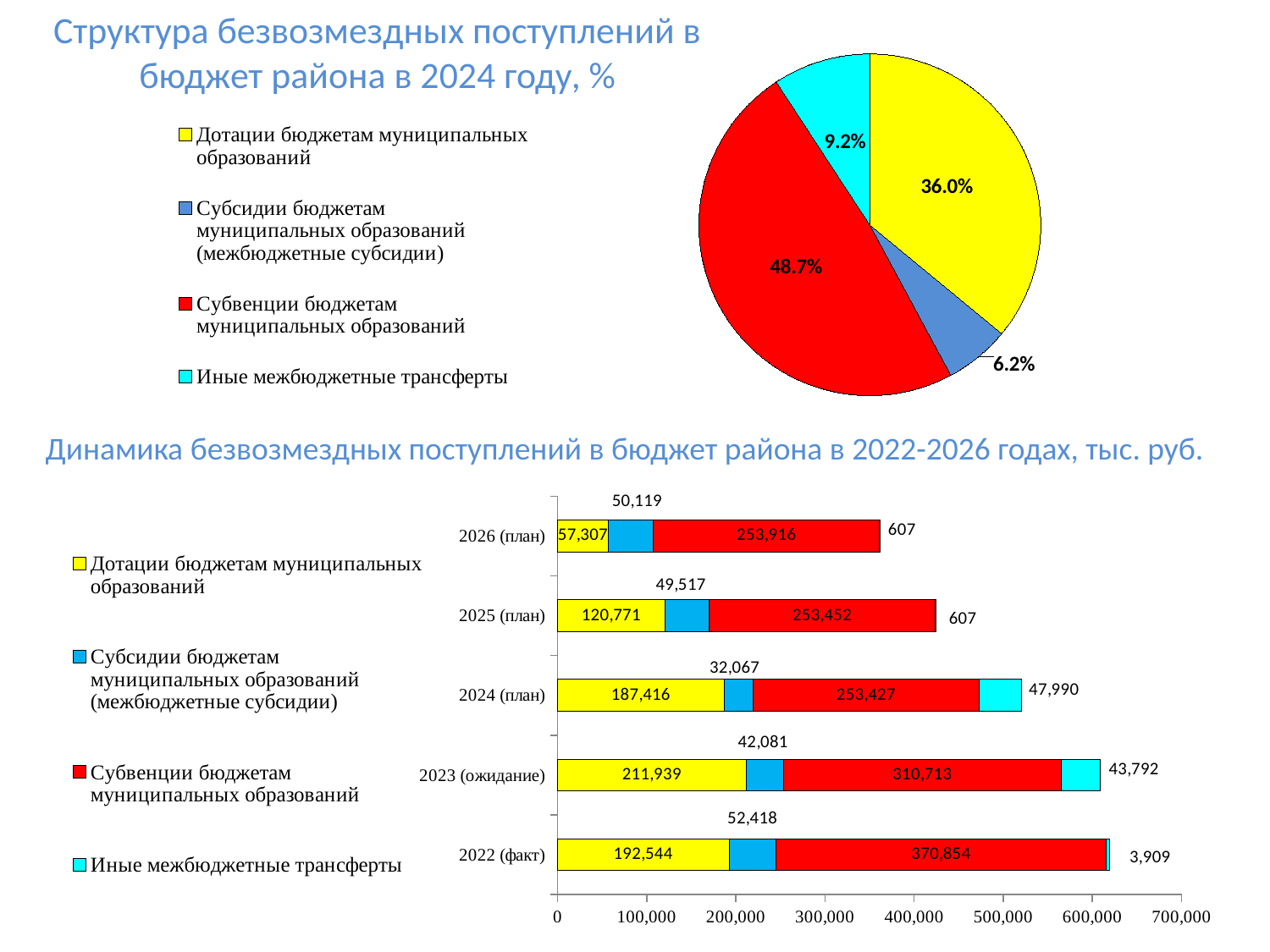
In the bar chart 'Динамика безвозмездных поступлений в бюджет района в 2022-2026 годах, тыс. руб.', which year has the highest value of Субвенции бюджетам муниципальных образований? 2022 (факт) In the pie chart 'Структура безвозмездных поступлений в бюджет района в 2024 году, %', how many slices does the pie have? 4 What type of chart is the lower chart 'Динамика безвозмездных поступлений в бюджет района в 2022-2026 годах, тыс. руб.'? Stacked bar chart In the bar chart 'Динамика безвозмездных поступлений в бюджет района в 2022-2026 годах, тыс. руб.', what is the difference between Дотации бюджетам муниципальных образований in 2023 (ожидание) and in 2024 (план)? 24,523 In the bar chart 'Динамика безвозмездных поступлений в бюджет района в 2022-2026 годах, тыс. руб.', how many series does the legend list? 4 In the pie chart 'Структура безвозмездных поступлений в бюджет района в 2024 году, %', what share is shown for Субвенции бюджетам муниципальных образований? 48.7% In the bar chart 'Динамика безвозмездных поступлений в бюджет района в 2022-2026 годах, тыс. руб.', what is the value of Иные межбюджетные трансферты for 2024 (план)? 47,990 In the bar chart 'Динамика безвозмездных поступлений в бюджет района в 2022-2026 годах, тыс. руб.', what is the value of Дотации бюджетам муниципальных образований for 2026 (план)? 57,307 In the pie chart 'Структура безвозмездных поступлений в бюджет района в 2024 году, %', what share is shown for Иные межбюджетные трансферты? 9.2% In the bar chart 'Динамика безвозмездных поступлений в бюджет района в 2022-2026 годах, тыс. руб.', what is the value of Субвенции бюджетам муниципальных образований for 2022 (факт)? 370,854 In the pie chart 'Структура безвозмездных поступлений в бюджет района в 2024 году, %', which category has the smallest share? Субсидии бюджетам муниципальных образований (межбюджетные субсидии) In the bar chart 'Динамика безвозмездных поступлений в бюджет района в 2022-2026 годах, тыс. руб.', what is the total of the stacked bar for 2022 (факт)? 619,725